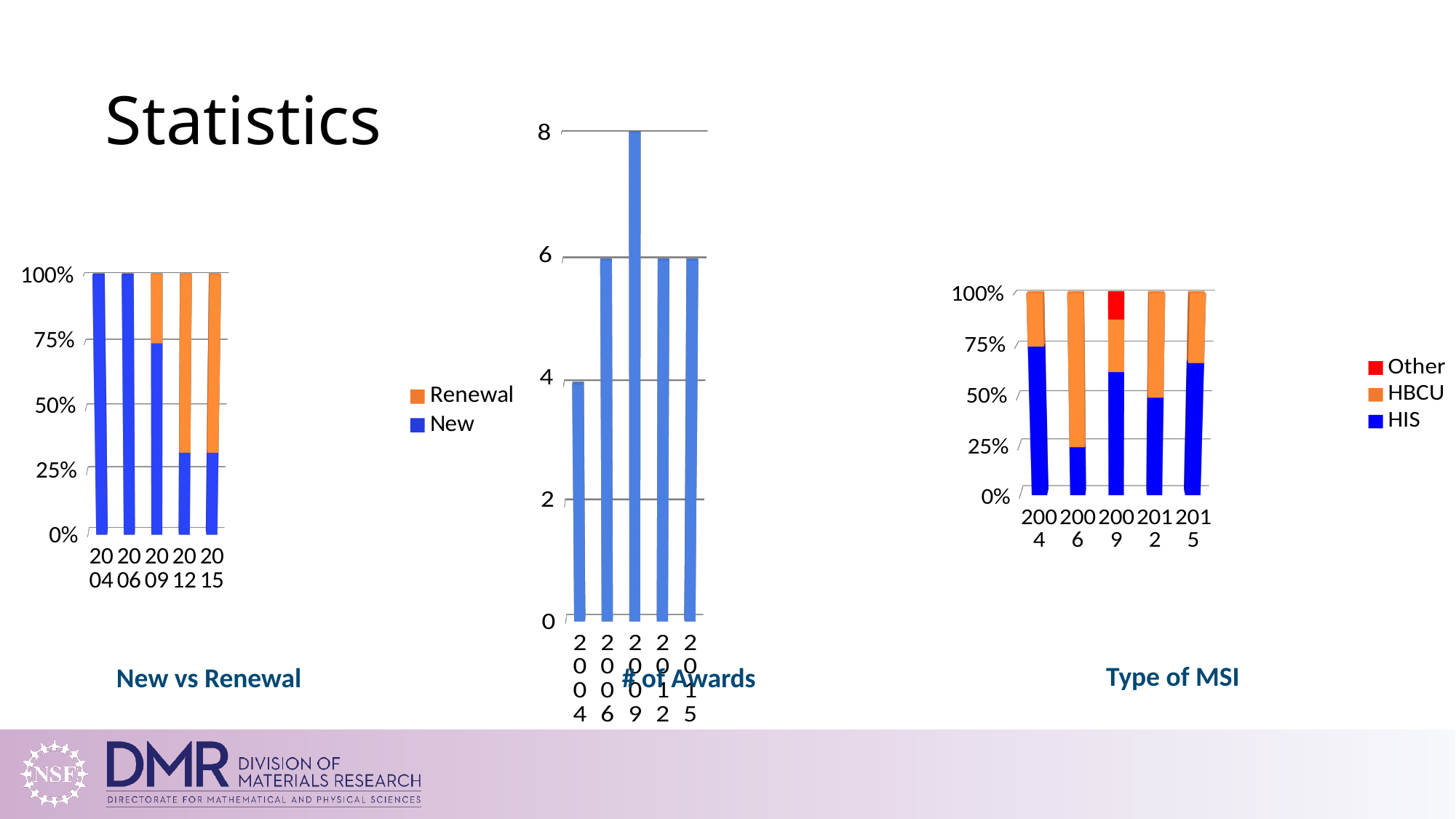
In the # of Awards chart, how many years are plotted? 5 In the # of Awards chart, what is the difference between the number of awards in 2009 and in 2004? 4 In the # of Awards chart, which year has the lowest number of awards? 2004 In the Type of MSI chart, is the HIS share for 2006 greater or less than 50%? less In the New vs Renewal chart, is the New share for 2009 greater or less than 50%? greater In the # of Awards chart, which year has the highest number of awards? 2009 In the Type of MSI chart, which year is the only one with an Other segment? 2009 In the # of Awards chart, how many awards are shown for 2004? 4 In the Type of MSI chart, how many series does the legend list? 3 In the New vs Renewal chart, is the New share for 2012 greater or less than 50%? less In the # of Awards chart, how many awards are shown for 2009? 8 What kind of chart is the # of Awards chart? bar chart